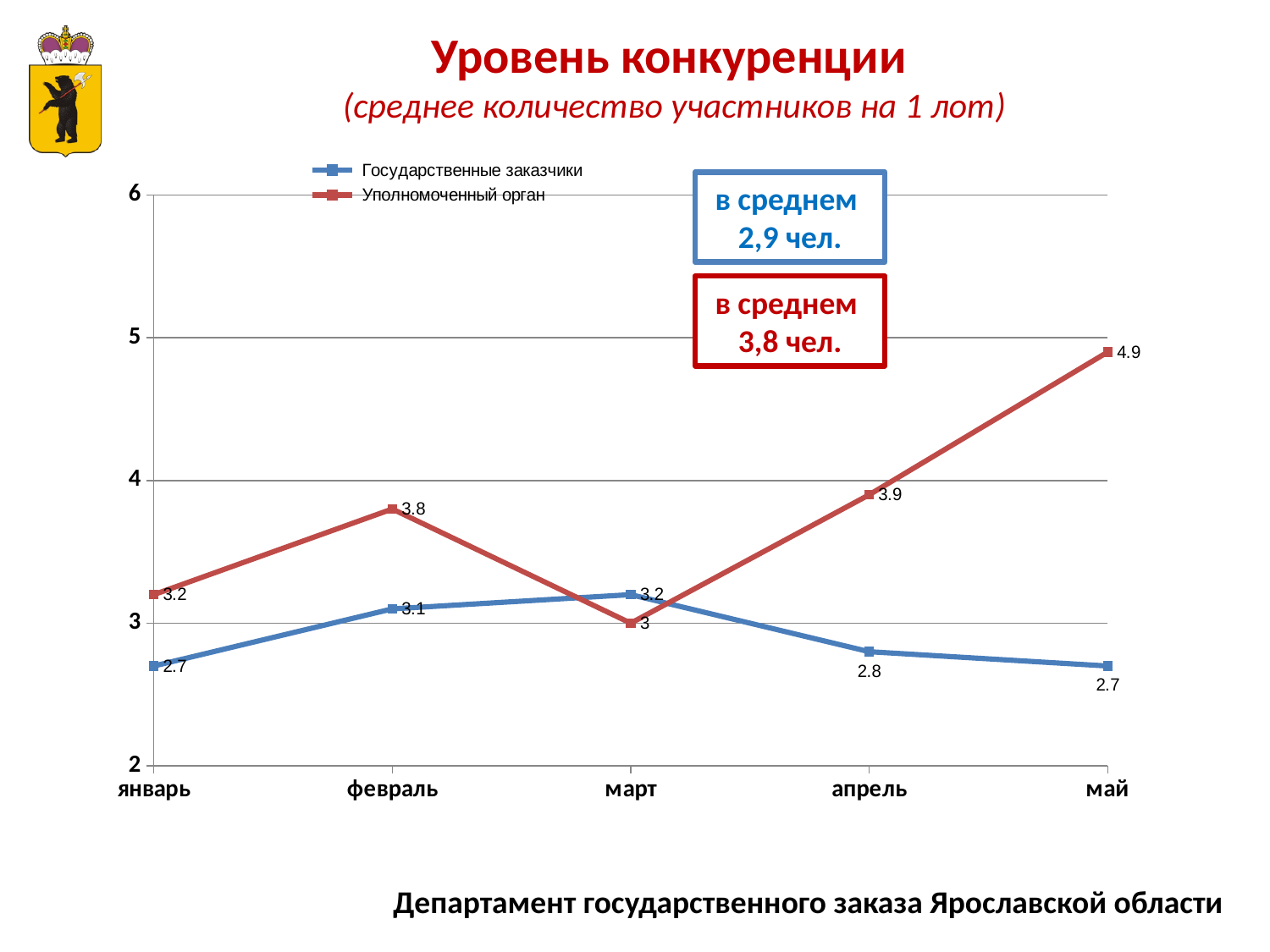
What is the value for Уполномоченный орган in март? 3 What is the value for Государственные заказчики in февраль? 3.1 What kind of chart is shown on the slide? line chart Does the value for Уполномоченный орган rise or fall from март to май? rise Which series has the larger value in март, Государственные заказчики or Уполномоченный орган? Государственные заказчики In which month is the value for Уполномоченный орган highest? май What is the value for Уполномоченный орган in май? 4.9 In which month is the value for Уполномоченный орган lowest? март How many months are plotted along the x axis? 5 What is the difference between Уполномоченный орган and Государственные заказчики in май? 2.2 In which month is the value for Государственные заказчики highest? март How many series does the legend list? 2